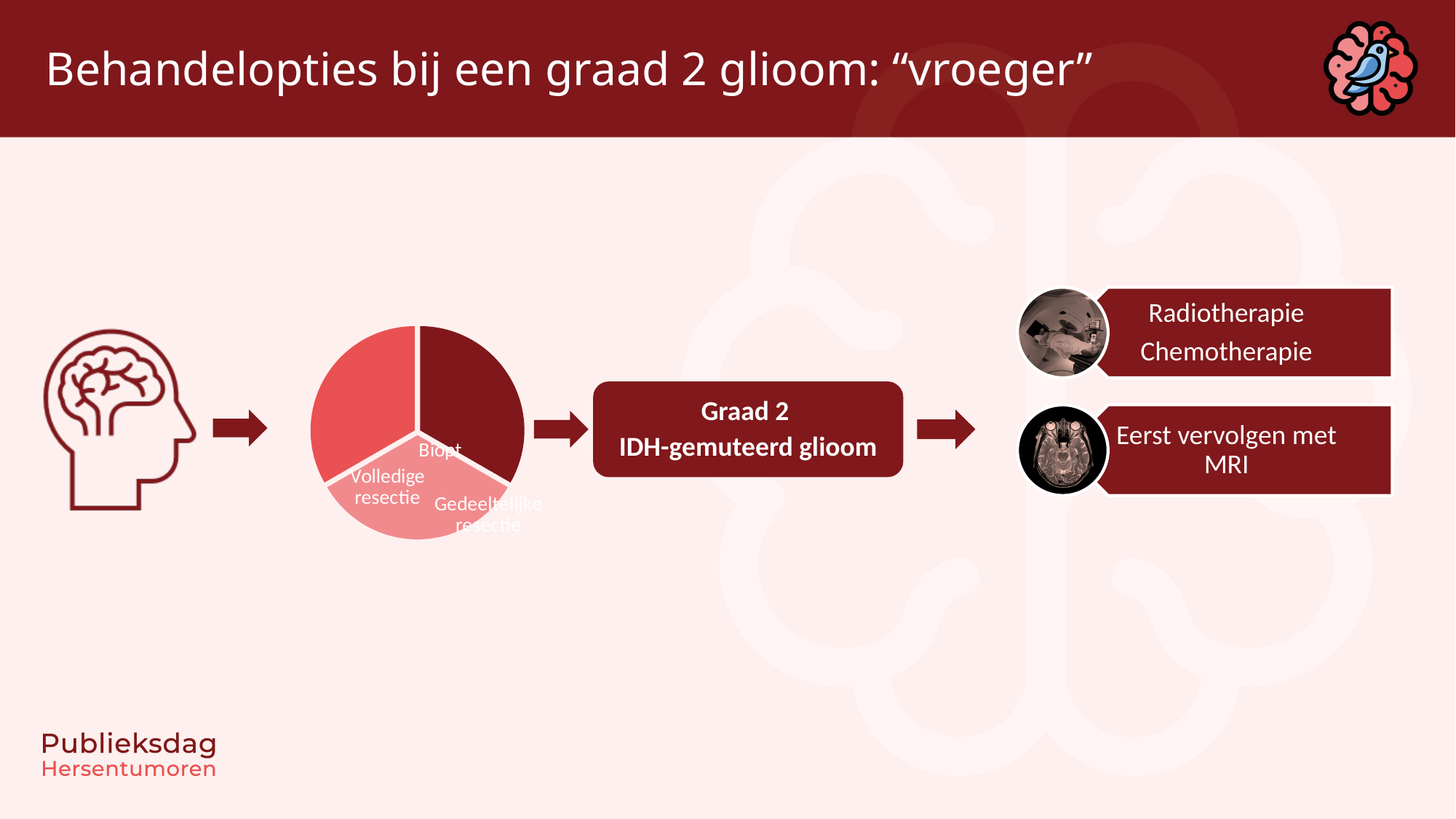
What are the three categories shown in the pie chart? Biopt, Volledige resectie, Gedeeltelijke resectie Which slice of the pie chart is coloured the lightest pink? Gedeeltelijke resectie Which slice of the pie chart is coloured the darkest red? Biopt How many slices does the pie chart have? 3 What kind of chart is shown on the slide? pie chart